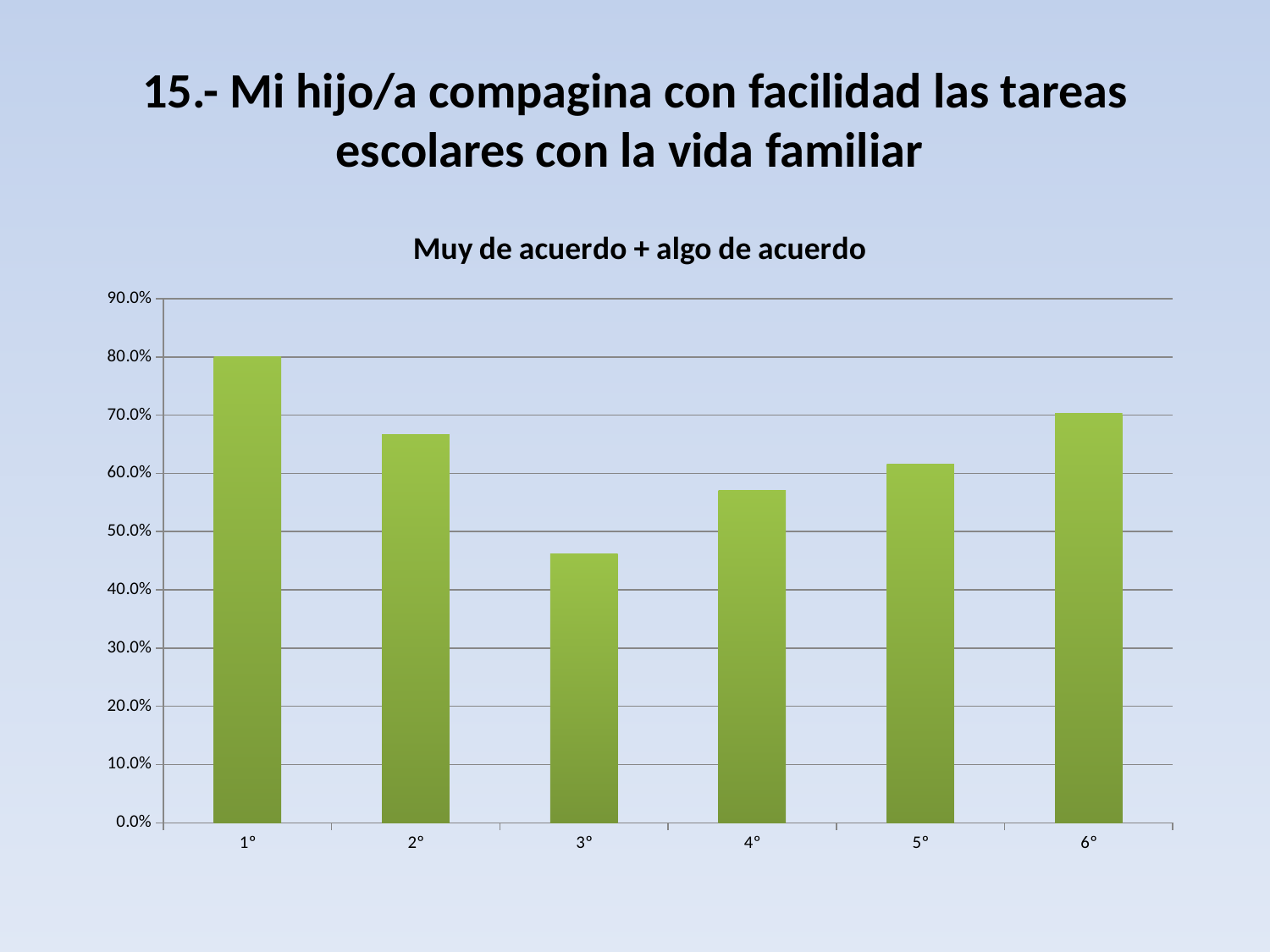
What is the highest value shown on the y axis of the chart? 90.0% Which category has the highest bar in the chart? 1° Which has a larger value, 2° or 4°? 2° Is the value for 3° greater or less than 50.0%? less Is the value for 5° greater or less than 70.0%? less Which category has the lowest bar in the chart? 3° What is the title shown directly above the chart? Muy de acuerdo + algo de acuerdo How many categories are shown on the x axis of the chart? 6 Is the value for 2° greater or less than 60.0%? greater Which has a larger value, 6° or 5°? 6° What kind of chart is shown on the slide? bar chart